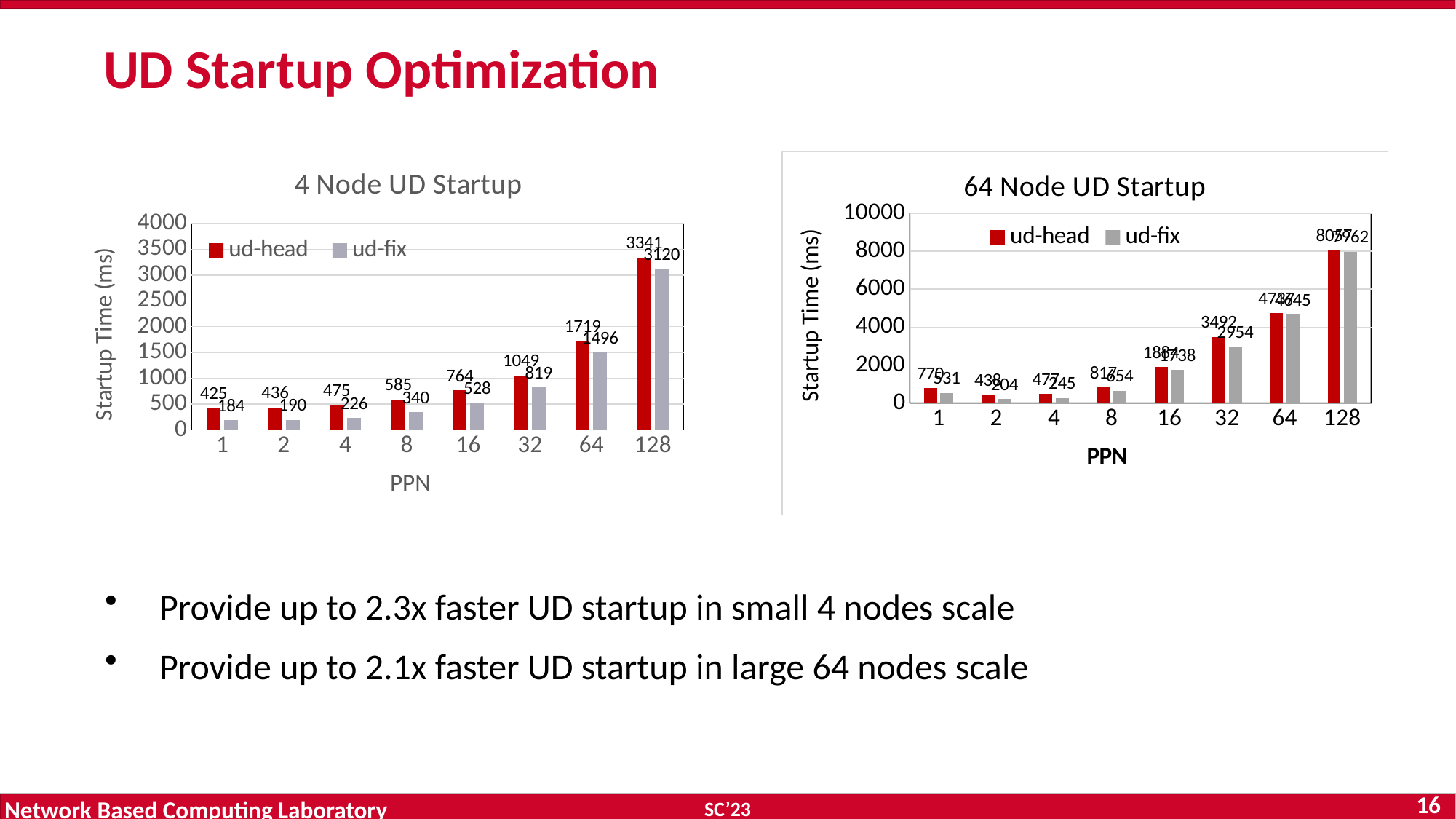
In the 64 Node UD Startup chart, which is larger at PPN 4: ud-head or ud-fix? ud-head In the 64 Node UD Startup chart, is the ud-head value at PPN 128 greater or less than 6000? greater How many PPN categories are shown on the x axis of the 4 Node UD Startup chart? 8 In the 4 Node UD Startup chart, at which PPN is the ud-fix startup time lowest? 1 In the 64 Node UD Startup chart, what is the ud-fix startup time at PPN 2? 204 In the 4 Node UD Startup chart, what is the ud-head startup time at PPN 128? 3341 In the 64 Node UD Startup chart, what is the ud-head startup time at PPN 32? 3492 How many series does the legend of the 64 Node UD Startup chart list? 2 In the 4 Node UD Startup chart, what is the ud-fix value at PPN 32? 819 In the 4 Node UD Startup chart, what is the difference between ud-head and ud-fix at PPN 64? 223 In the 4 Node UD Startup chart, what is the ud-fix startup time at PPN 1? 184 In the 4 Node UD Startup chart, at which PPN is the ud-head startup time highest? 128